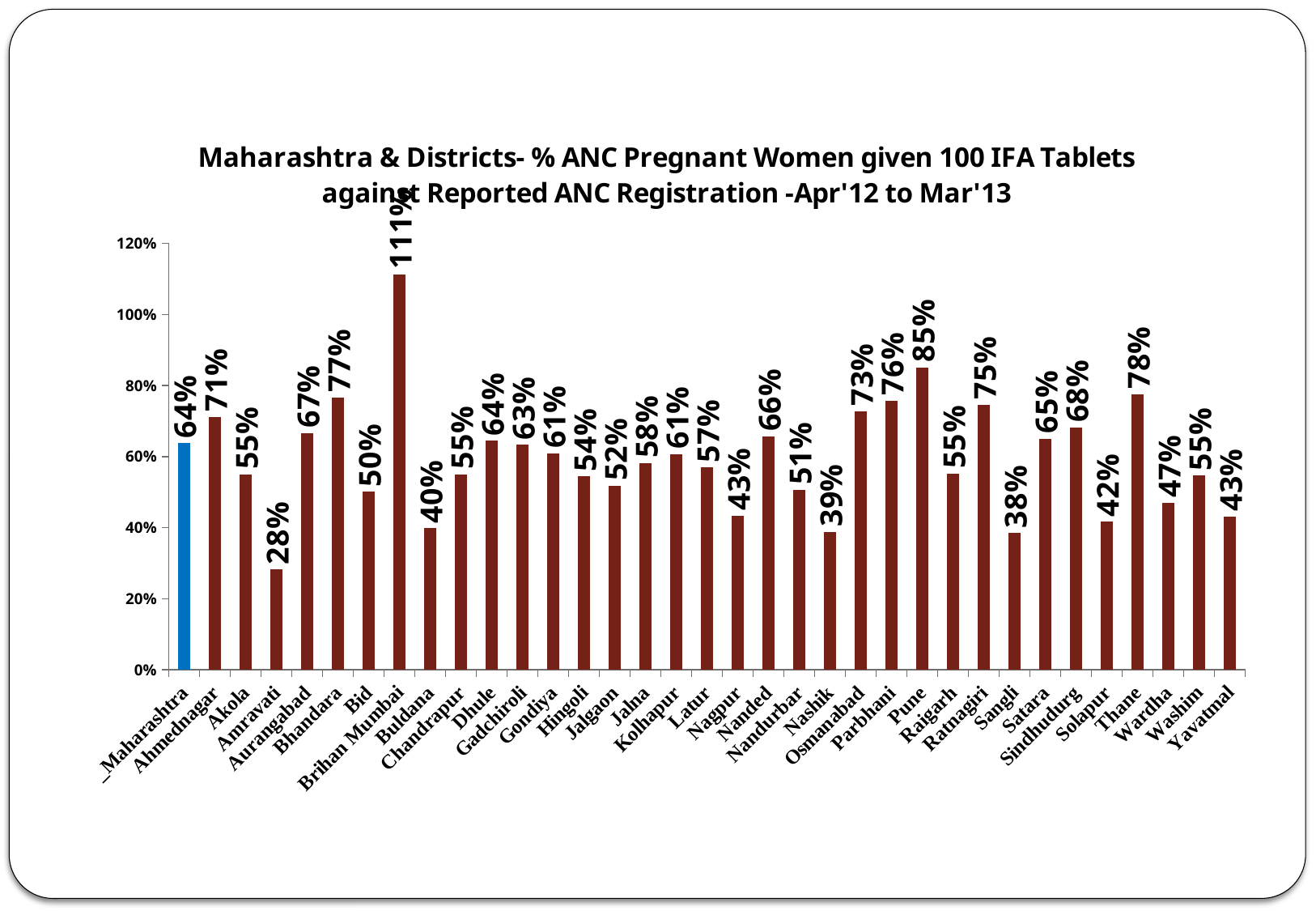
What is the value for Pune? 85% What is the value for Amravati? 28% Which bar is coloured differently (blue) from the others? _Maharashtra Which district has the highest value? Brihan Mumbai What kind of chart is shown on the slide? bar chart How many bars are plotted on the chart? 35 What is the value for Brihan Mumbai? 111% Which district has the lowest value? Amravati What is the value for _Maharashtra? 64% Which has a larger value, Bhandara or Osmanabad? Bhandara What is the difference between the values for Thane and Nashik? 39% Is the value for Sangli greater or less than 40%? less